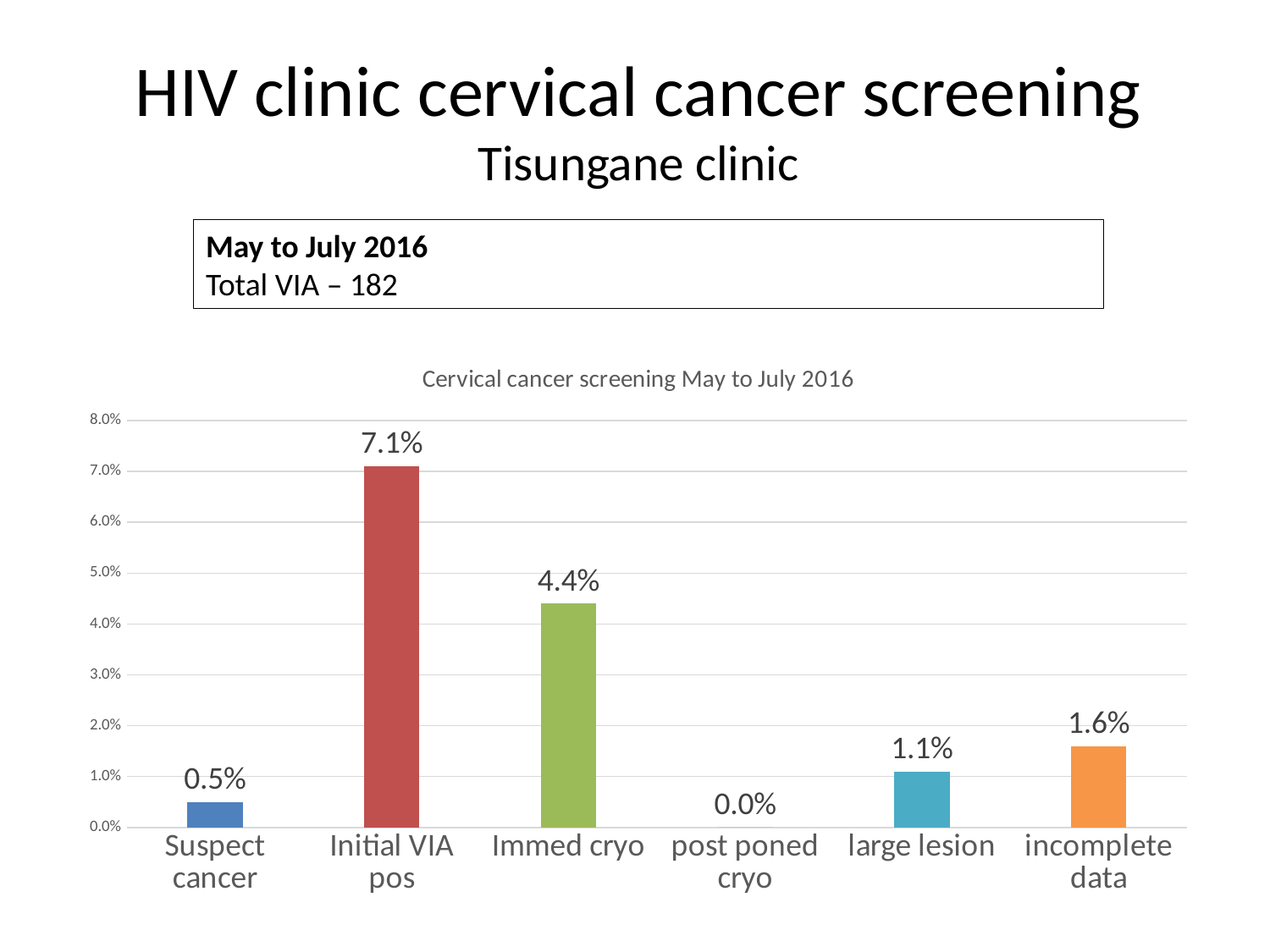
Which category has the lowest value? post poned cryo How many categories are shown on the x axis? 6 What is the value for post poned cryo? 0.0% What is the title of the chart? Cervical cancer screening May to July 2016 Is the value for Suspect cancer greater or less than 1.0%? less Which is larger, large lesion or incomplete data? incomplete data Which category has the highest value? Initial VIA pos What is the value for Immed cryo? 4.4% What is the difference between Initial VIA pos and Immed cryo? 2.7% What is the value for Initial VIA pos? 7.1% What is the value for incomplete data? 1.6% What kind of chart is shown? bar chart